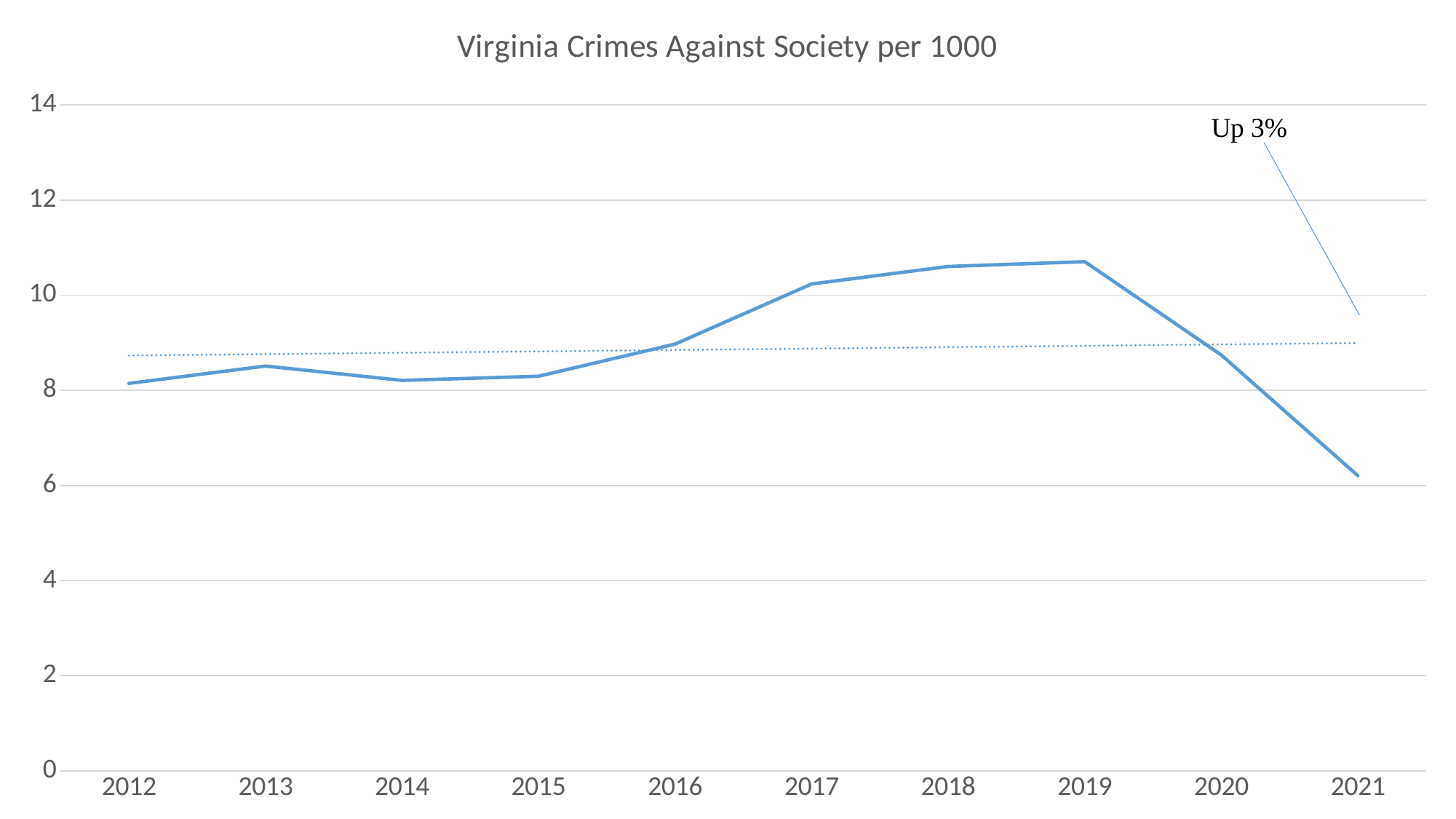
Do the values rise or fall from 2019 to 2021? fall What kind of chart is shown on the slide? line chart Is the value for 2017 greater or less than 10? greater How many years are plotted along the x axis? 10 Which is larger, the value for 2012 or the value for 2021? 2012 Which is larger, the value for 2017 or the value for 2014? 2017 Is the value for 2021 greater or less than 8? less Is the value for 2020 greater or less than 10? less What does the text annotation near the top right of the chart say? Up 3% Which year has the lowest value? 2021 What is the title of the chart? Virginia Crimes Against Society per 1000